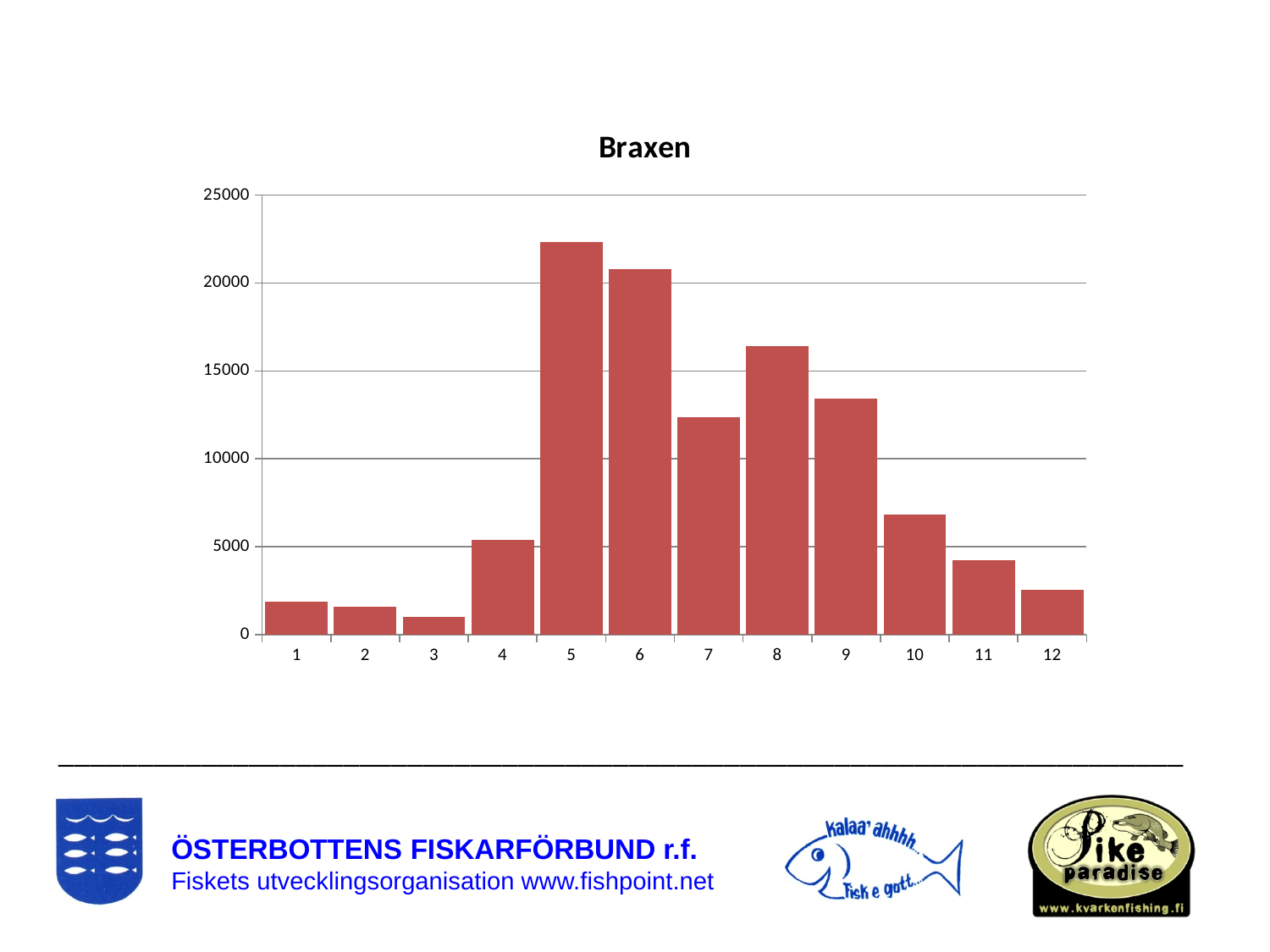
What kind of chart is shown on the slide? bar chart Is the value for category 5 greater or less than 20000? greater Is the value for category 7 greater or less than 15000? less Is the value for category 10 greater or less than 5000? greater What is the title of the chart? Braxen Which category has the highest value in the chart? 5 How many categories are shown on the x axis of the chart? 12 Which category has the lowest value in the chart? 3 Which is larger, the value for category 8 or the value for category 9? 8 Do the values rise or fall from category 9 to category 12? fall